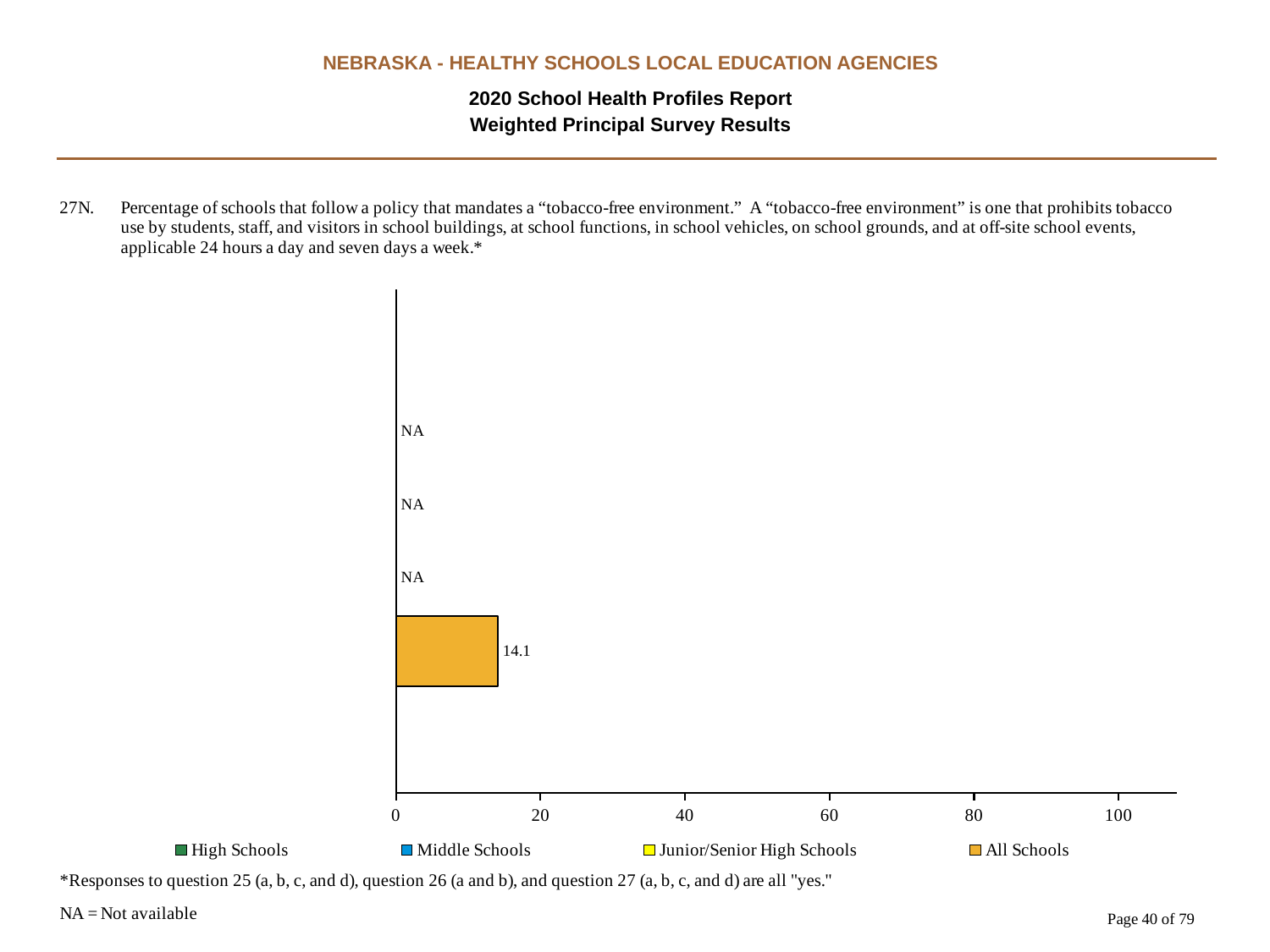
What does NA stand for according to the note on the slide? Not available How many series are labelled NA on the chart? 3 What is the highest value shown on the x axis? 100 Is the value for All Schools greater or less than 10? greater What value is shown for High Schools? NA What value is shown for Middle Schools? NA What value is shown for Junior/Senior High Schools? NA Which series is the only one with a plotted bar? All Schools What kind of chart is shown on the slide? bar chart How many series does the legend list? 4 Is the value for All Schools greater or less than 20? less What is the value shown for All Schools? 14.1